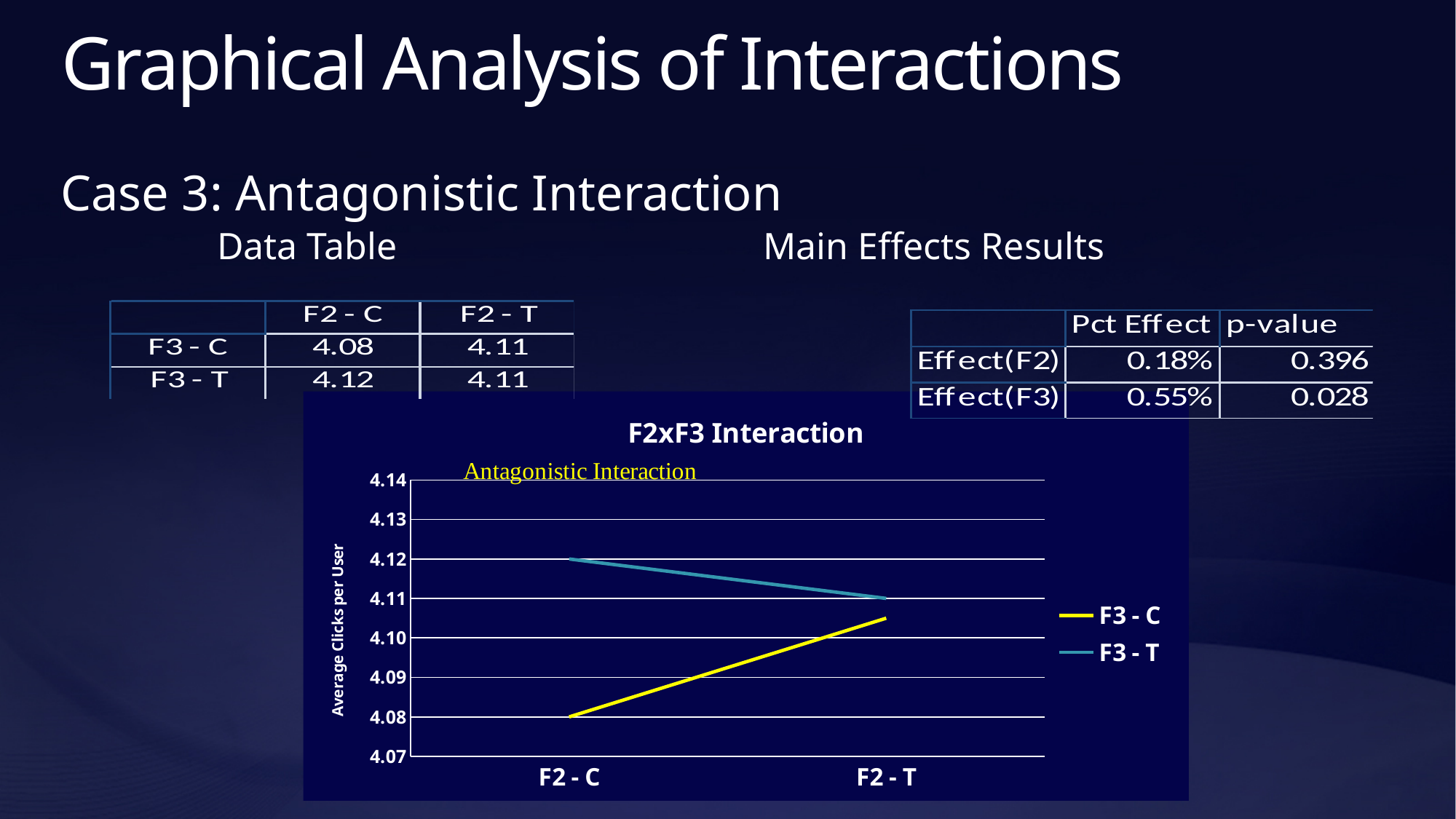
Does the F3 - C line rise or fall from F2 - C to F2 - T? rise What is the value of the F3 - C series at F2 - C in the F2xF3 Interaction chart? 4.08 What is the label of the y axis of the F2xF3 Interaction chart? Average Clicks per User Does the F3 - T line rise or fall from F2 - C to F2 - T? fall What is the value of the F3 - T series at F2 - C in the F2xF3 Interaction chart? 4.12 What is the difference between the F3 - T and F3 - C values at F2 - C? 0.04 What is the value of the F3 - T series at F2 - T in the F2xF3 Interaction chart? 4.11 At F2 - C, which series has the larger value, F3 - C or F3 - T? F3 - T How many categories are on the x axis of the F2xF3 Interaction chart? 2 What kind of chart is shown on the slide? line chart How many series does the legend of the F2xF3 Interaction chart list? 2 Is the value of the F3 - C series at F2 - T greater or less than 4.09? greater